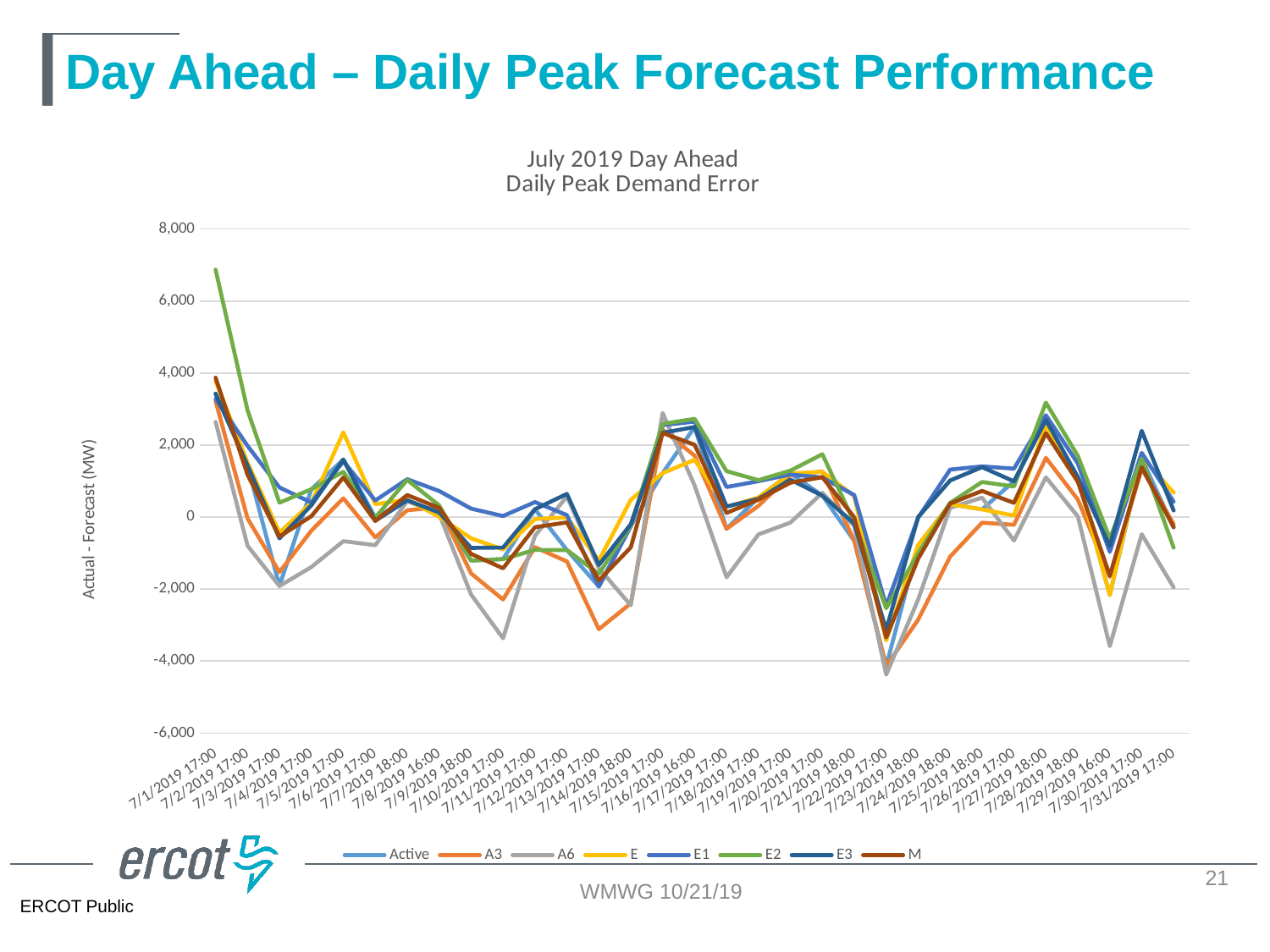
On 7/1/2019 17:00, which is larger, the value for E2 or the value for A6? E2 How many dates are plotted along the x axis? 31 What is the label of the vertical axis? Actual - Forecast (MW) What kind of chart is shown on the slide? Line chart Is the value for E2 on 7/1/2019 17:00 greater or less than 6,000? greater What is the title of the chart? July 2019 Day Ahead Daily Peak Demand Error Is the value for A6 on 7/29/2019 16:00 greater or less than -2,000? less How many series does the legend list? 8 Which series has the highest value on 7/1/2019 17:00? E2 Do the series values rise or fall from 7/1/2019 17:00 to 7/3/2019 17:00? fall Is the value for A3 on 7/14/2019 18:00 greater or less than -2,000? less